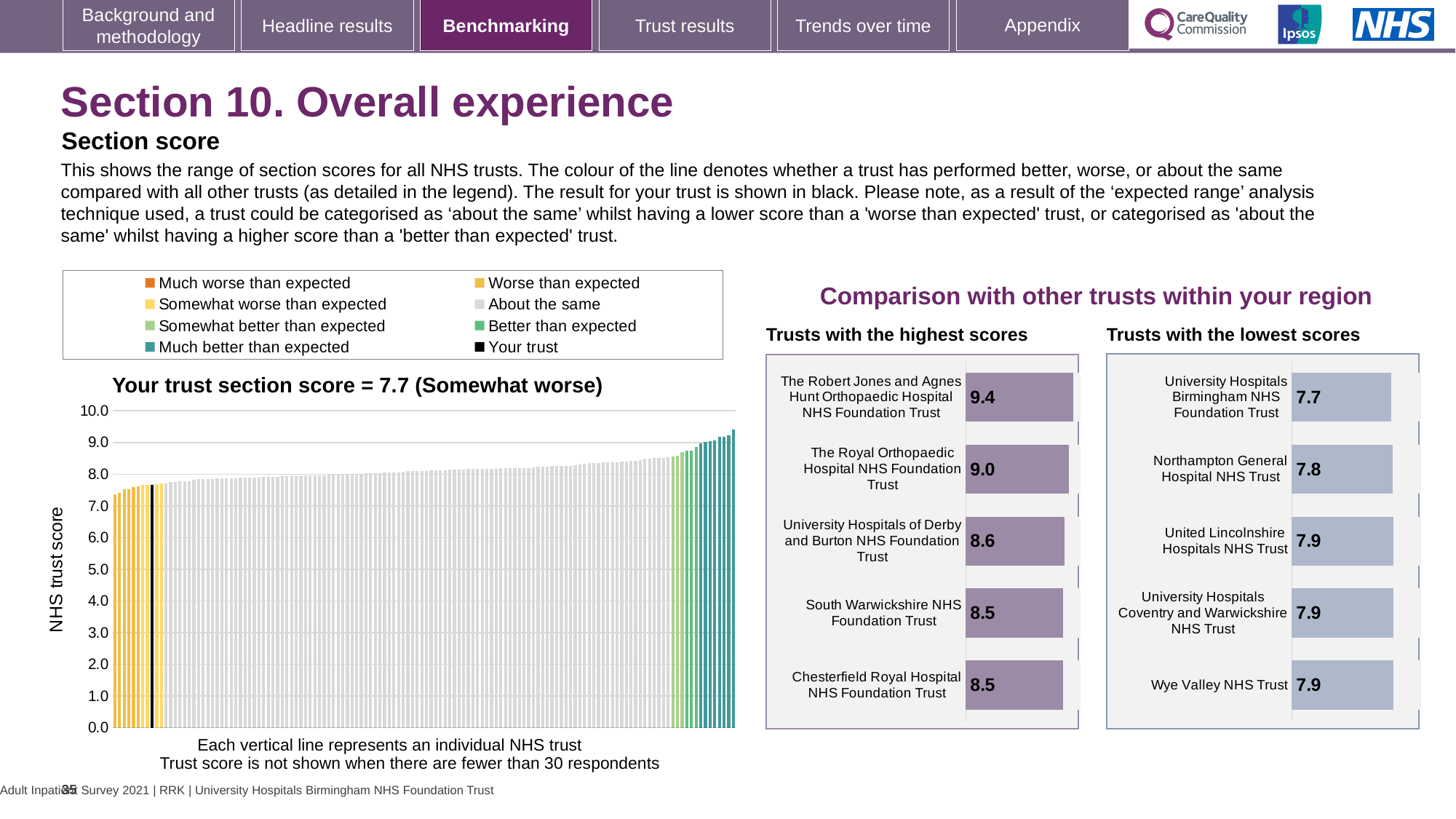
On the 'Your trust section score' chart, what is the section score for your trust? 7.7 On the 'Trusts with the lowest scores' chart, which trust has the lowest score? University Hospitals Birmingham NHS Foundation Trust On the 'Trusts with the highest scores' chart, which has the higher score: The Royal Orthopaedic Hospital NHS Foundation Trust or University Hospitals of Derby and Burton NHS Foundation Trust? The Royal Orthopaedic Hospital NHS Foundation Trust On the 'Your trust section score' chart, what is the label on the y axis? NHS trust score On the 'Trusts with the highest scores' chart, what is the difference between the scores of The Robert Jones and Agnes Hunt Orthopaedic Hospital NHS Foundation Trust and University Hospitals of Derby and Burton NHS Foundation Trust? 0.8 On the 'Trusts with the highest scores' chart, what is the score for The Robert Jones and Agnes Hunt Orthopaedic Hospital NHS Foundation Trust? 9.4 On the 'Your trust section score' chart, how many entries does the legend list? 8 On the 'Trusts with the highest scores' chart, how many trusts are listed? 5 On the 'Trusts with the lowest scores' chart, what is the score for Northampton General Hospital NHS Trust? 7.8 On the 'Your trust section score' chart, is the value of the highest bar greater or less than 9.0? greater On the 'Your trust section score' chart, what kind of chart is shown? Bar chart On the 'Your trust section score' chart, do the bars rise or fall from left to right along the x axis? Rise